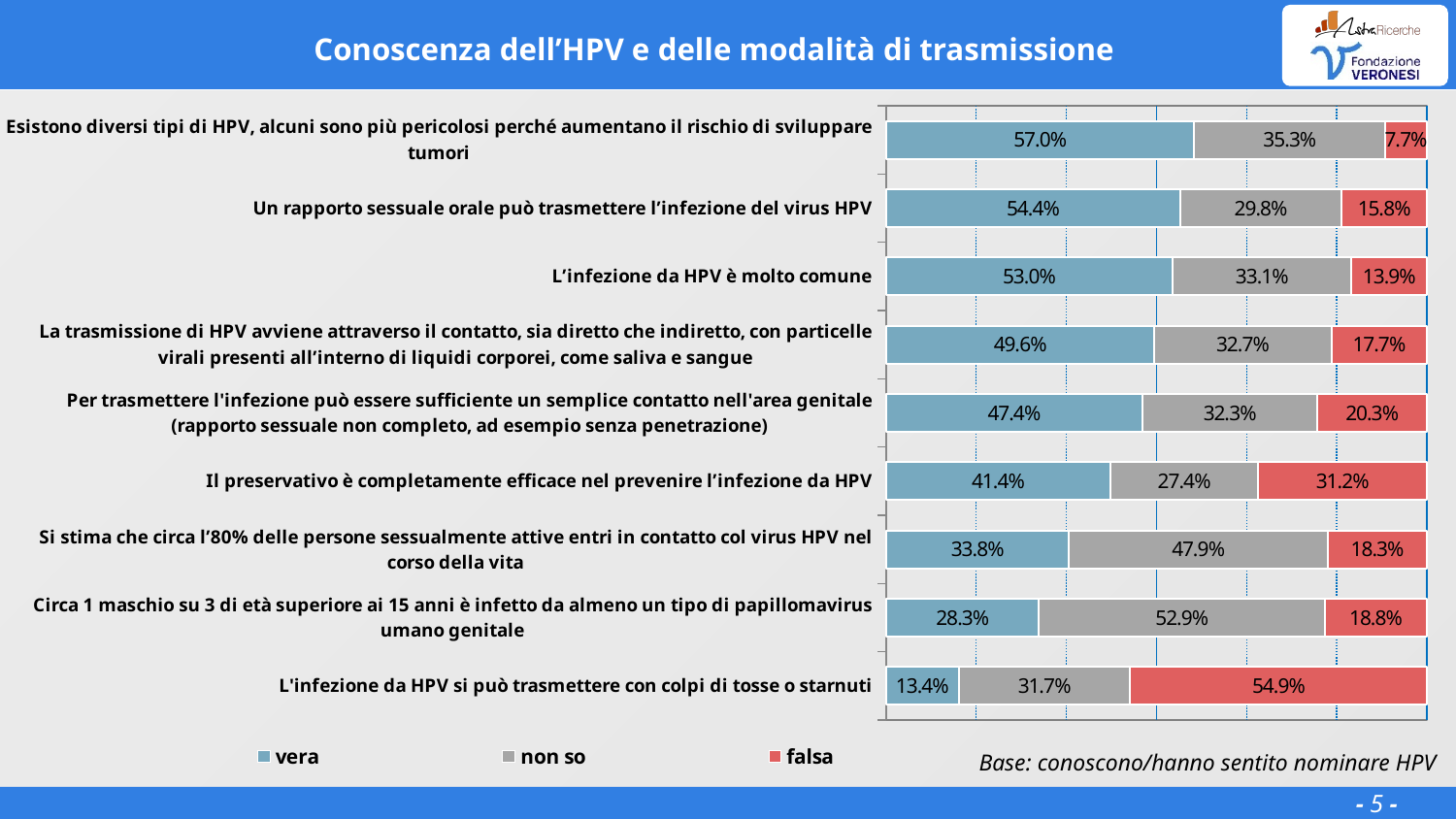
Which statement has the highest "non so" percentage? Circa 1 maschio su 3 di età superiore ai 15 anni è infetto da almeno un tipo di papillomavirus umano genitale What percentage answered "falsa" for the statement "L'infezione da HPV si può trasmettere con colpi di tosse o starnuti"? 54.9% Which statement has the highest "vera" percentage? Esistono diversi tipi di HPV, alcuni sono più pericolosi perché aumentano il rischio di sviluppare tumori What percentage answered "vera" for the statement "L'infezione da HPV è molto comune"? 53.0% How many statements are shown in the chart? 9 What percentage answered "non so" for the statement "Si stima che circa l'80% delle persone sessualmente attive entri in contatto col virus HPV nel corso della vita"? 47.9% Which statement has the lowest "vera" percentage? L'infezione da HPV si può trasmettere con colpi di tosse o starnuti What is the difference in percentage points between the "non so" value for "Circa 1 maschio su 3 di età superiore ai 15 anni è infetto da almeno un tipo di papillomavirus umano genitale" and the "non so" value for "Il preservativo è completamente efficace nel prevenire l'infezione da HPV"? 25.5 percentage points Which statement has a larger "falsa" percentage: "Il preservativo è completamente efficace nel prevenire l'infezione da HPV" or "Per trasmettere l'infezione può essere sufficiente un semplice contatto nell'area genitale"? Il preservativo è completamente efficace nel prevenire l'infezione da HPV What is the total of the stacked bar for "Un rapporto sessuale orale può trasmettere l'infezione del virus HPV"? 100.0% How many series does the legend list? 3 What kind of chart is shown on the slide? Stacked bar chart